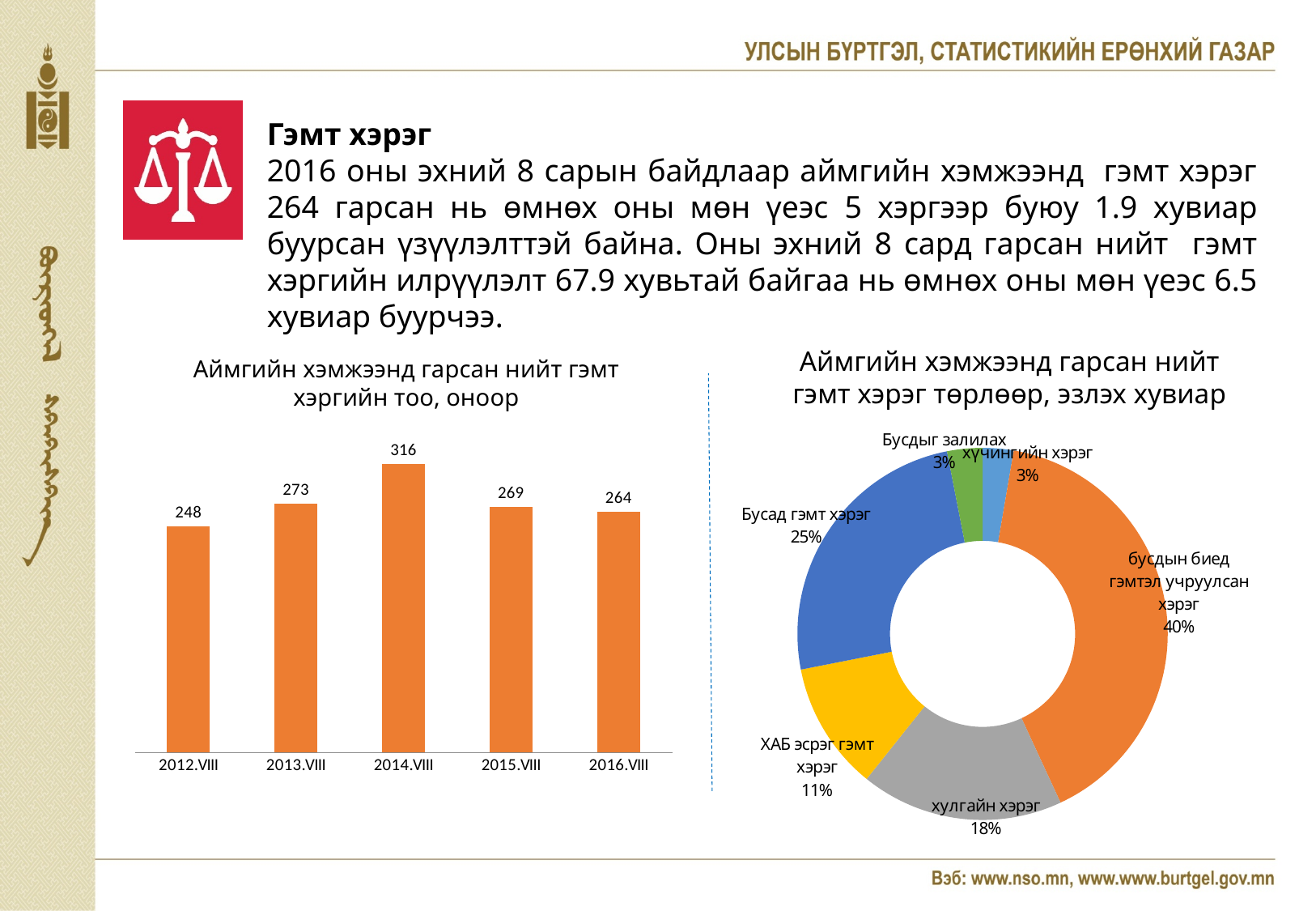
How many bars are shown in the left chart 'Аймгийн хэмжээнд гарсан нийт гэмт хэргийн тоо, оноор'? 5 In the left bar chart, which is larger: the value for 2013.VIII or 2015.VIII? 2013.VIII What type of chart is the left chart 'Аймгийн хэмжээнд гарсан нийт гэмт хэргийн тоо, оноор'? Bar chart In the right chart 'Аймгийн хэмжээнд гарсан нийт гэмт хэрэг төрлөөр, эзлэх хувиар', what share does 'ХАБ эсрэг гэмт хэрэг' have? 11% In the right chart 'Аймгийн хэмжээнд гарсан нийт гэмт хэрэг төрлөөр, эзлэх хувиар', which category has the largest share? бусдын биед гэмтэл учруулсан хэрэг In the left bar chart, what is the difference between the values for 2014.VIII and 2016.VIII? 52 In the right chart 'Аймгийн хэмжээнд гарсан нийт гэмт хэрэг төрлөөр, эзлэх хувиар', what share does 'хулгайн хэрэг' have? 18% In the left chart 'Аймгийн хэмжээнд гарсан нийт гэмт хэргийн тоо, оноор', what is the value for 2014.VIII? 316 What type of chart is the right chart 'Аймгийн хэмжээнд гарсан нийт гэмт хэрэг төрлөөр, эзлэх хувиар'? Doughnut chart In the left bar chart, which year has the highest number of crimes? 2014.VIII In the left chart 'Аймгийн хэмжээнд гарсан нийт гэмт хэргийн тоо, оноор', what is the value for 2012.VIII? 248 In the left bar chart, which year has the lowest number of crimes? 2012.VIII